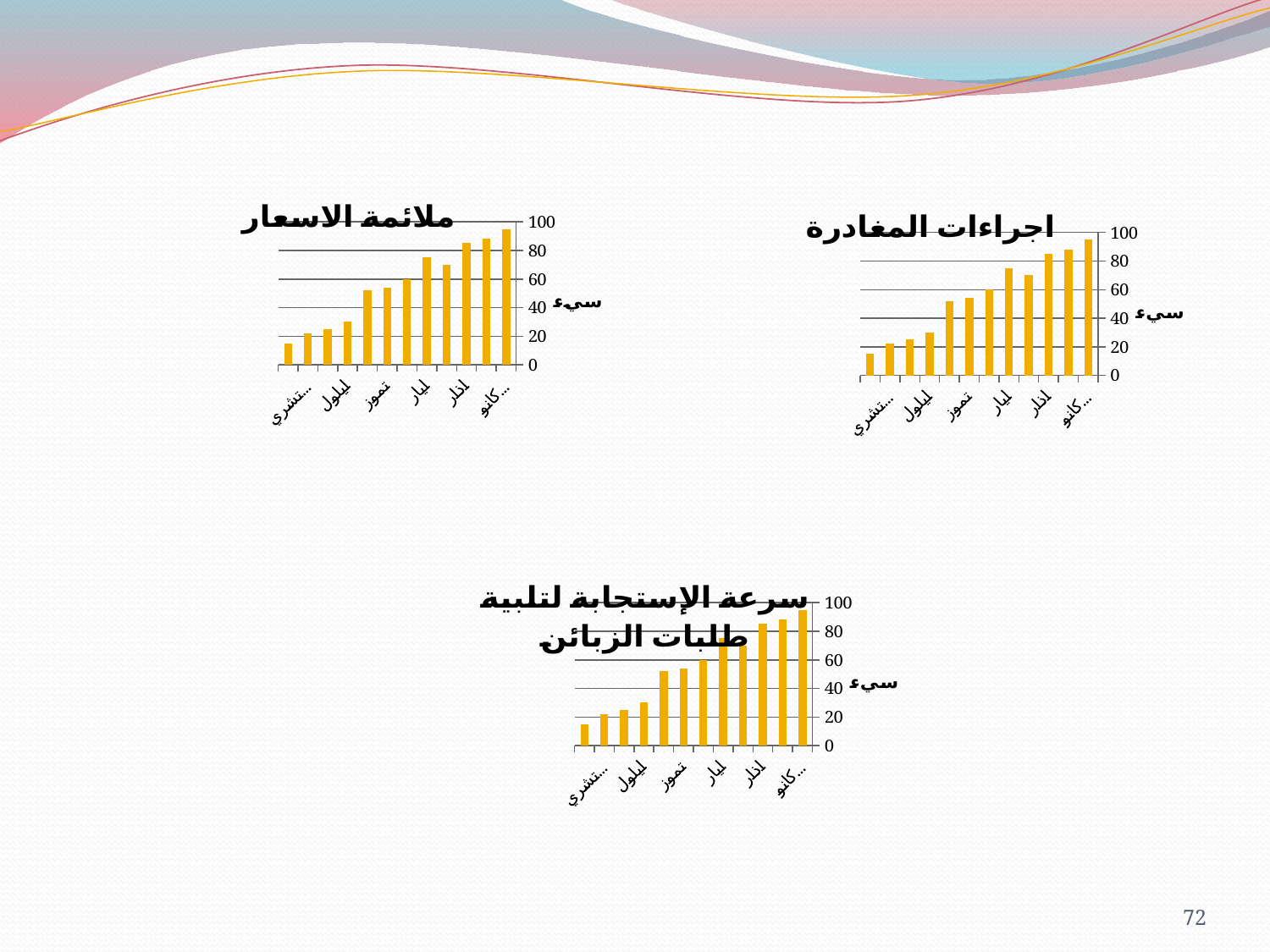
In the 'سرعة الإستجابة لتلبية طلبات الزبائن' chart, how many bars are plotted? 12 In the 'ملائمة الاسعار' chart, do the values generally rise or fall from left to right along the x axis? rise In the 'ملائمة الاسعار' chart, is the value for 'اذار' greater or less than 60? greater In the 'اجراءات المغادرة' chart, do the values generally rise or fall from left to right along the x axis? rise In the 'اجراءات المغادرة' chart, is the value for 'كانو...' greater or less than 80? greater In the 'اجراءات المغادرة' chart, how many bars are plotted? 12 How many charts are shown on the slide? 3 What type of chart is the 'ملائمة الاسعار' chart? bar chart